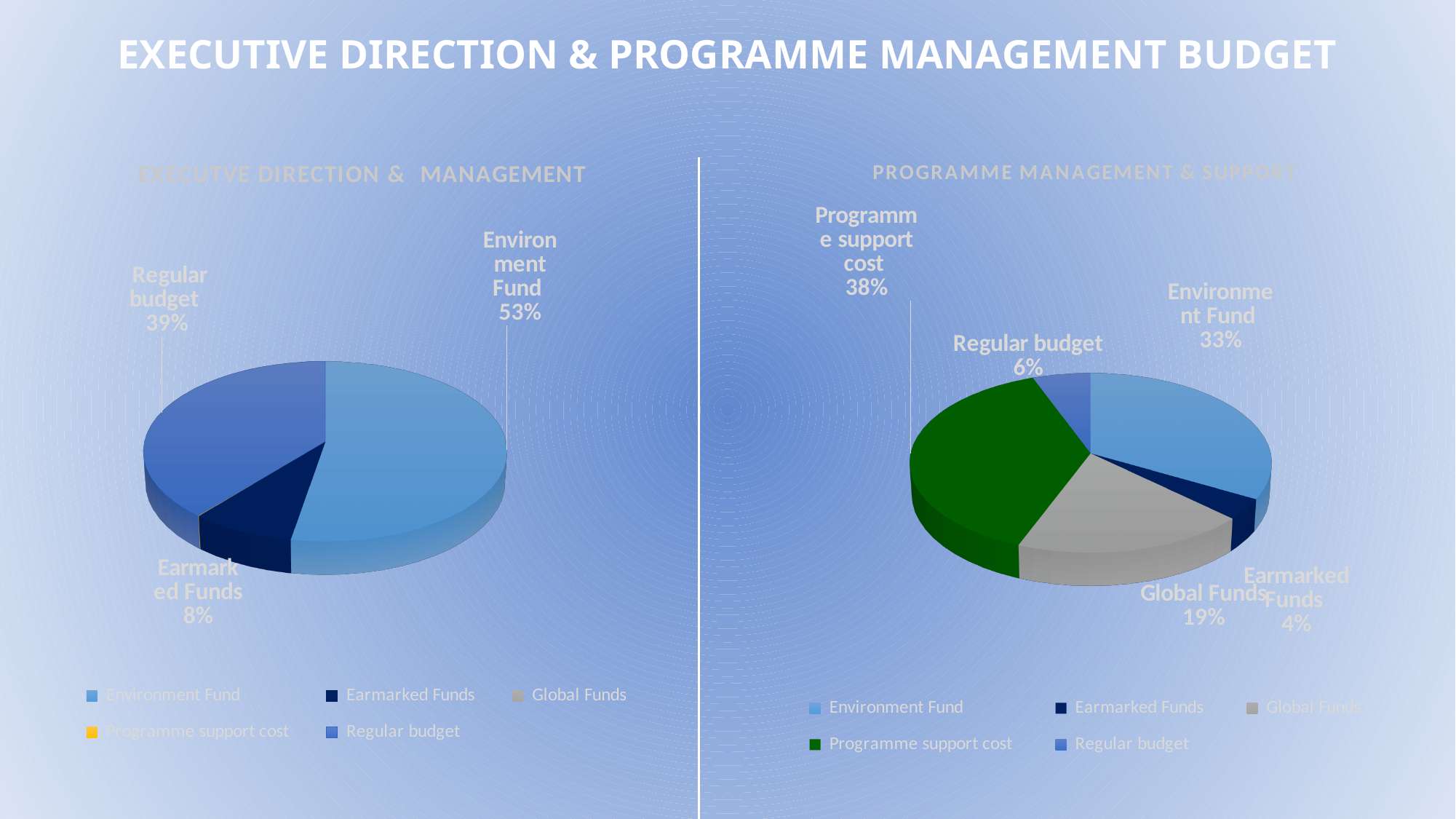
In the Executive Direction & Management chart, what share does the Regular budget have? 39% In the Programme Management & Support chart, which category has the largest share? Programme support cost In the Programme Management & Support chart, which category has the smallest share? Earmarked Funds In the Executive Direction & Management chart, what share does the Environment Fund have? 53% In the Programme Management & Support chart, which is larger: Regular budget or Earmarked Funds? Regular budget What type of chart is used on the left side of the slide? Pie chart In the Executive Direction & Management chart, which category has the smallest share? Earmarked Funds How many slices are shown in the Programme Management & Support pie chart? 5 In the Programme Management & Support chart, what is the difference between the Environment Fund share and the Global Funds share? 14% In the Programme Management & Support chart, what share does Programme support cost have? 38% In the Programme Management & Support chart, what share do Global Funds have? 19% In the Executive Direction & Management chart, what is the difference between the Environment Fund share and the Regular budget share? 14%